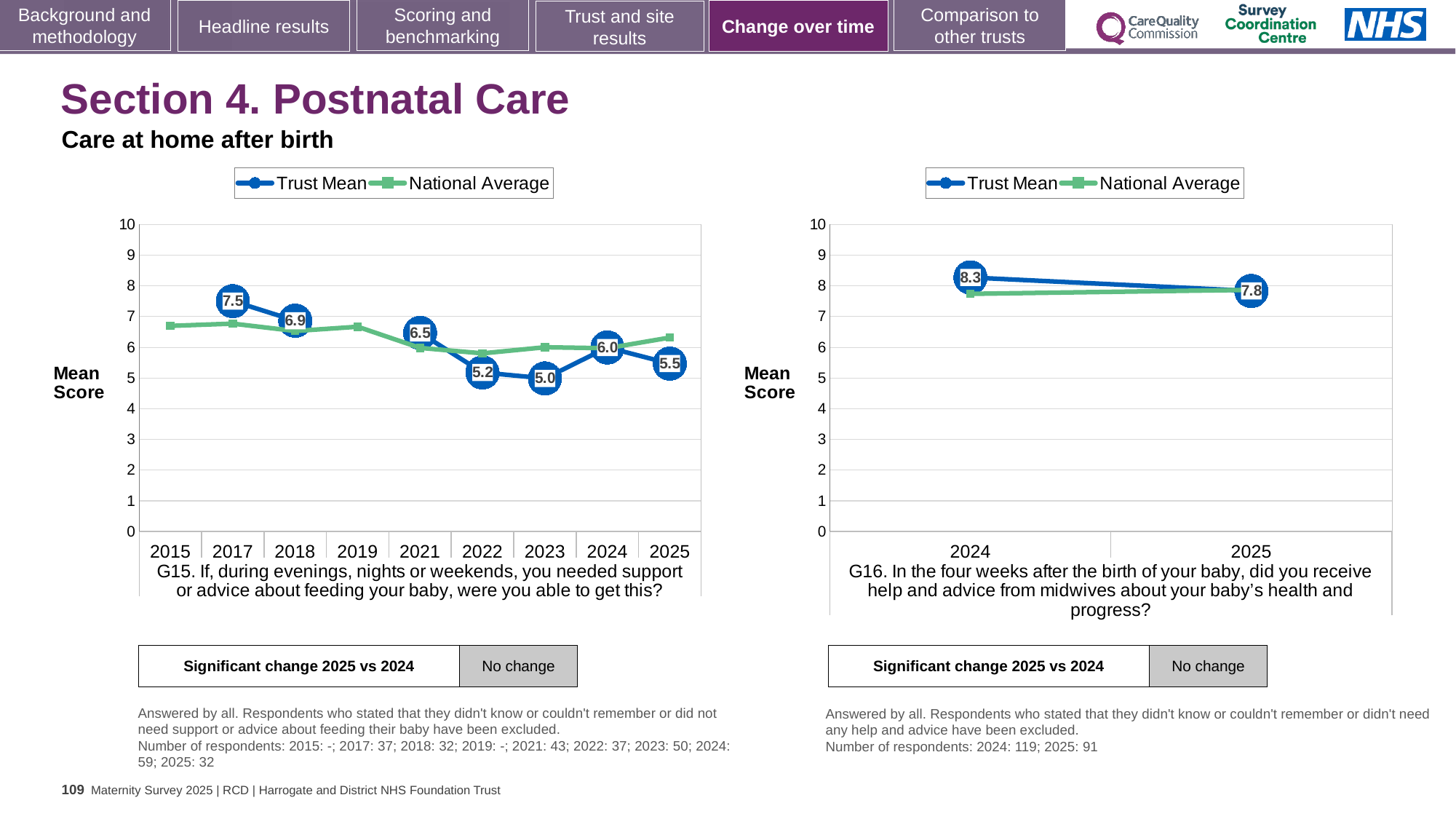
In the G15 chart, is the Trust Mean score for 2018 larger than the Trust Mean score for 2022? Yes In the G15 chart, what is the Trust Mean score for 2025? 5.5 How many series does the legend of the G15 chart list? 2 In the G15 chart, what is the difference between the Trust Mean scores for 2024 and 2025? 0.5 In the G16 chart, how many years are shown on the x axis? 2 In the G16 chart, what is the difference between the Trust Mean scores for 2024 and 2025? 0.5 In the G15 chart, which year has the lowest Trust Mean score? 2023 In the G16 chart, what is the Trust Mean score for 2024? 8.3 In the G15 chart, what is the Trust Mean score for 2017? 7.5 In the G15 chart, is the National Average for 2015 greater or less than 6? greater In the G15 chart, what is the Trust Mean score for 2023? 5.0 In the G15 chart, which year has the highest Trust Mean score? 2017